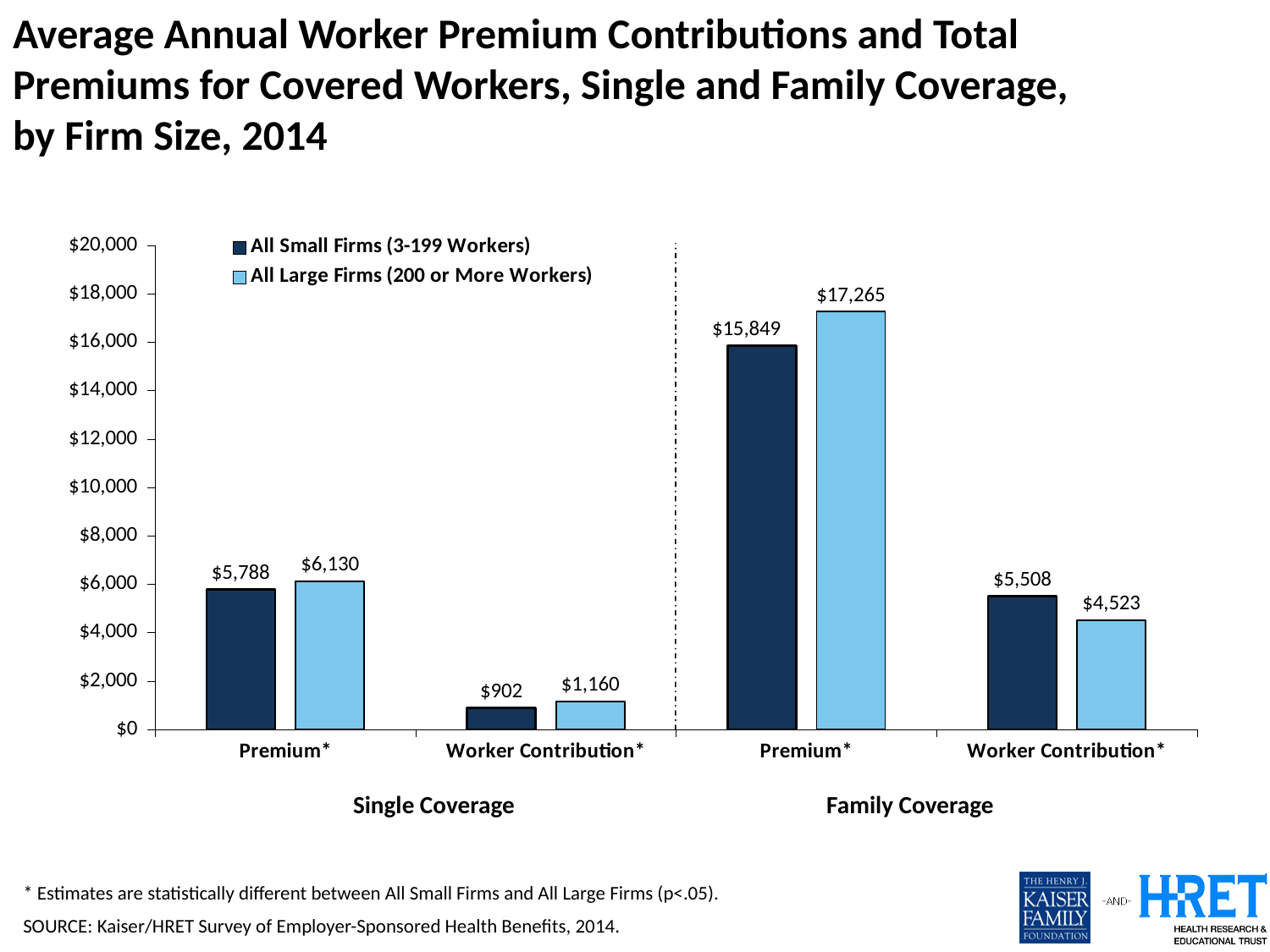
What is the average annual premium for family coverage at All Small Firms (3-199 Workers)? $15,849 What is the worker contribution for family coverage at All Large Firms (200 or More Workers)? $4,523 What kind of chart is shown on the slide? Bar chart What is the difference between the family coverage premium at All Large Firms and at All Small Firms? $1,416 For family coverage worker contribution, which is larger: All Small Firms or All Large Firms? All Small Firms What is the average annual premium for single coverage at All Small Firms (3-199 Workers)? $5,788 What is the difference between the single coverage worker contribution at All Large Firms and at All Small Firms? $258 Which bar on the chart has the highest value? Family Coverage Premium, All Large Firms ($17,265) What is the worker contribution for single coverage at All Large Firms (200 or More Workers)? $1,160 Is the family coverage premium for All Small Firms greater or less than $16,000? less Which bar on the chart has the lowest value? Single Coverage Worker Contribution, All Small Firms ($902) How many series does the legend list? 2